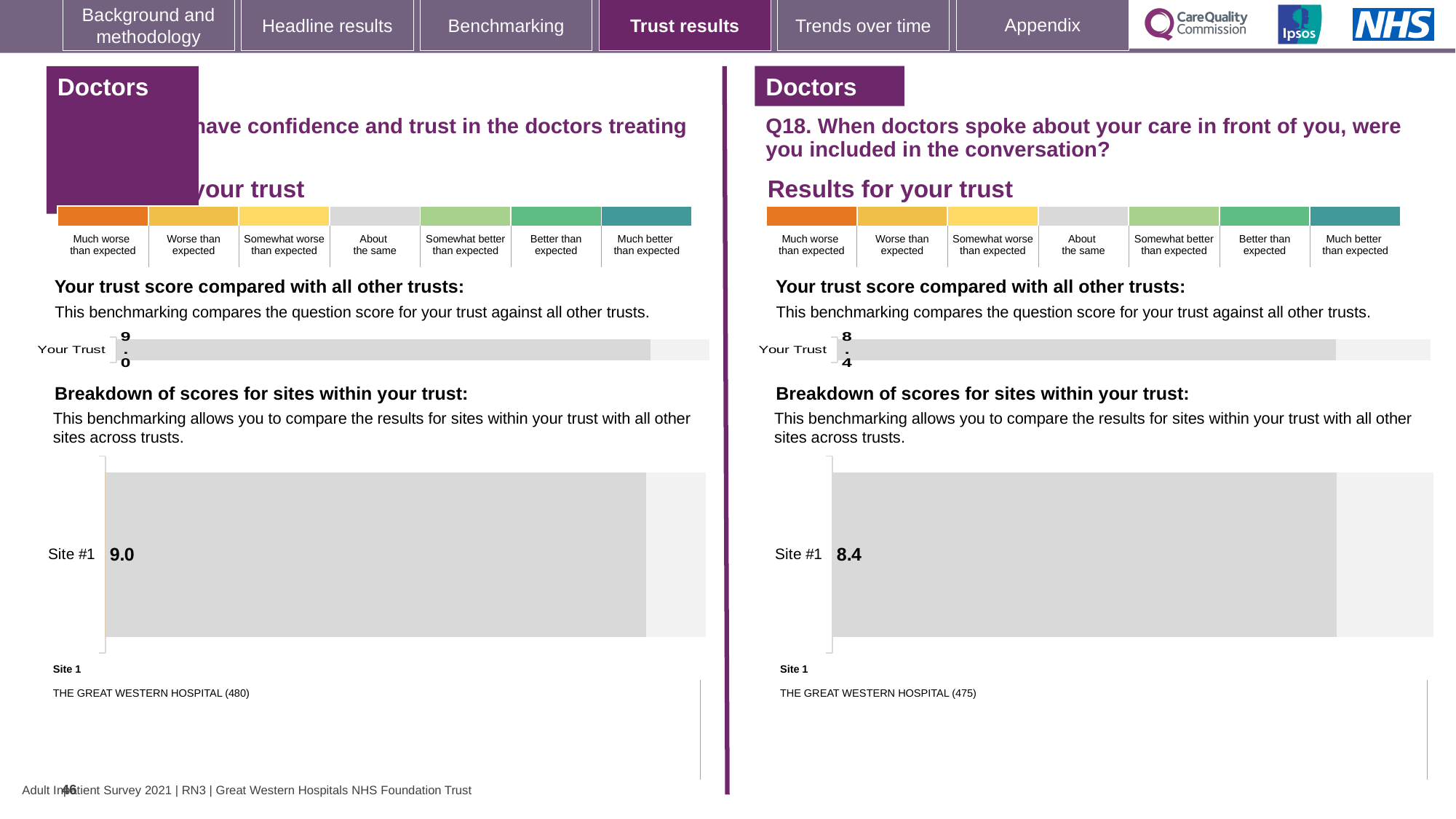
Which is larger: the Your Trust score on the left-hand side of the slide or the Your Trust score on the right-hand side (Q18)? Left-hand side (9.0) What kind of chart is used to show the Site #1 score on the right-hand side of the slide (Q18)? Bar chart On the left-hand side of the slide, what is the score shown for Site #1? 9.0 On the right-hand side of the slide (Q18), what is the score shown for Your Trust? 8.4 What is the difference between the Site #1 score on the left-hand side of the slide and the Site #1 score on the right-hand side (Q18)? 0.6 On the left-hand side of the slide, what is the score shown for Your Trust? 9.0 On the right-hand side of the slide (Q18), is the Site #1 score greater or less than the Your Trust score, or are they equal? Equal How many sites are shown in the 'Breakdown of scores for sites within your trust' chart on the left-hand side of the slide? 1 On the right-hand side of the slide (Q18), what is the score shown for Site #1? 8.4 What is the name of the site listed as Site 1 on the right-hand side of the slide (Q18)? THE GREAT WESTERN HOSPITAL (475) What is the name of the site listed as Site 1 on the left-hand side of the slide? THE GREAT WESTERN HOSPITAL (480) How many sites are shown in the 'Breakdown of scores for sites within your trust' chart on the right-hand side of the slide (Q18)? 1